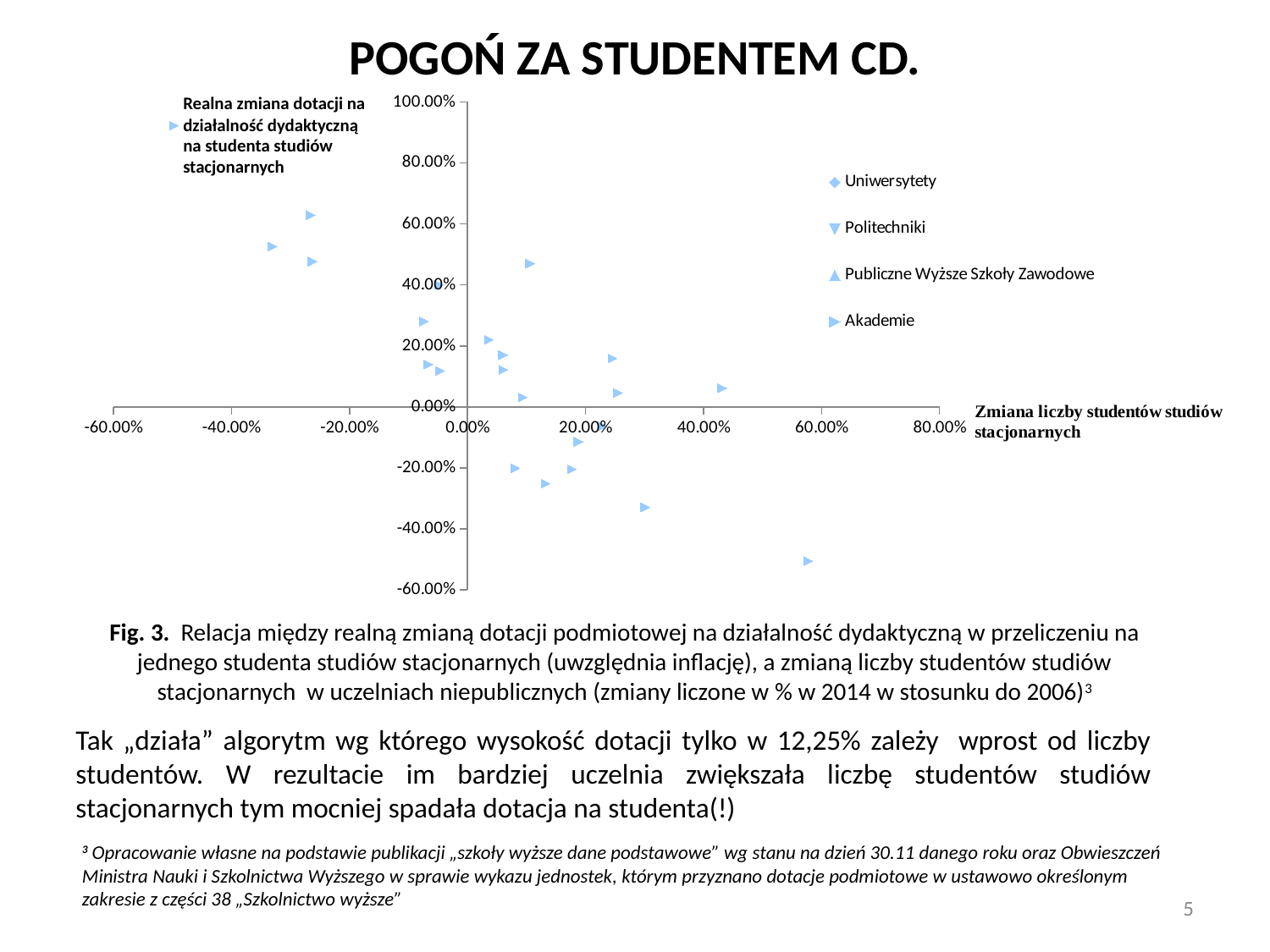
What is the highest tick value shown on the horizontal axis of the chart? 80.00% Is the vertical-axis value of the highest point on the chart greater or less than 40.00%? greater Is the horizontal-axis value of the leftmost point on the chart greater or less than -20.00%? less Is the horizontal-axis value of the rightmost point on the chart greater or less than 40.00%? greater What is the highest tick value shown on the vertical axis of the chart? 100.00% How many series does the chart legend list? 4 Which series are listed in the chart legend? Uniwersytety, Politechniki, Publiczne Wyższe Szkoły Zawodowe, Akademie What is the label of the horizontal axis of the chart? Zmiana liczby studentów studiów stacjonarnych What kind of chart is shown on the slide? scatter chart As the change in the number of students (x axis) increases, do the plotted values of the change in subsidy per student generally rise or fall? fall